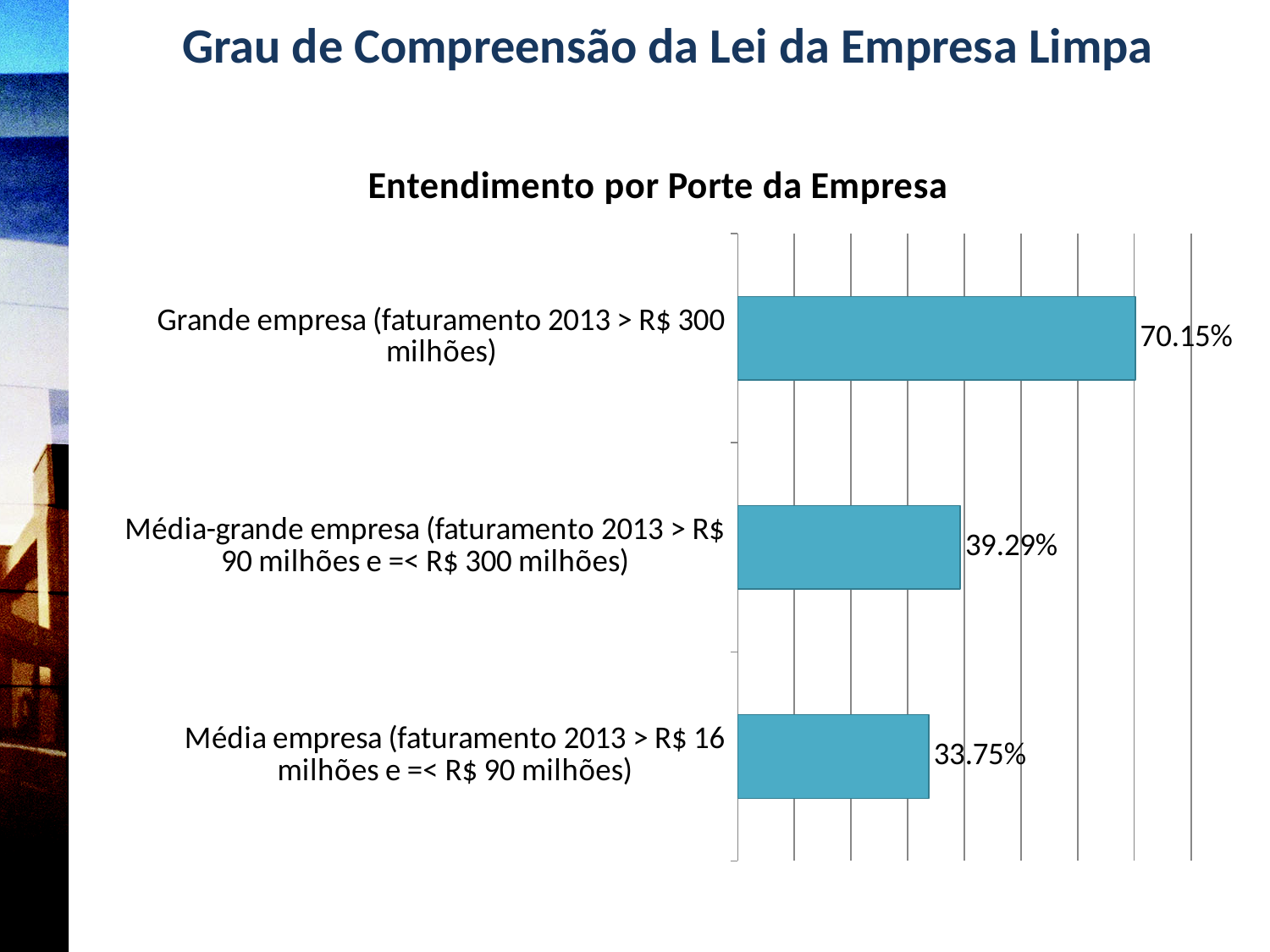
What is the value for Grande empresa (faturamento 2013 > R$ 300 milhões)? 70.15% What is the difference between the value for Média-grande empresa and the value for Média empresa? 5.54% What kind of chart is shown on the slide? Bar chart What is the value for Média-grande empresa (faturamento 2013 > R$ 90 milhões e =< R$ 300 milhões)? 39.29% What is the difference between the value for Grande empresa and the value for Média empresa? 36.40% Which company size category has the highest value? Grande empresa (faturamento 2013 > R$ 300 milhões) Which company size category has the lowest value? Média empresa (faturamento 2013 > R$ 16 milhões e =< R$ 90 milhões) How many company size categories are shown in the chart? 3 What is the difference between the value for Grande empresa and the value for Média-grande empresa? 30.86% Which is larger, the value for Média-grande empresa or the value for Média empresa? Média-grande empresa What is the value for Média empresa (faturamento 2013 > R$ 16 milhões e =< R$ 90 milhões)? 33.75% What is the title of the chart? Entendimento por Porte da Empresa